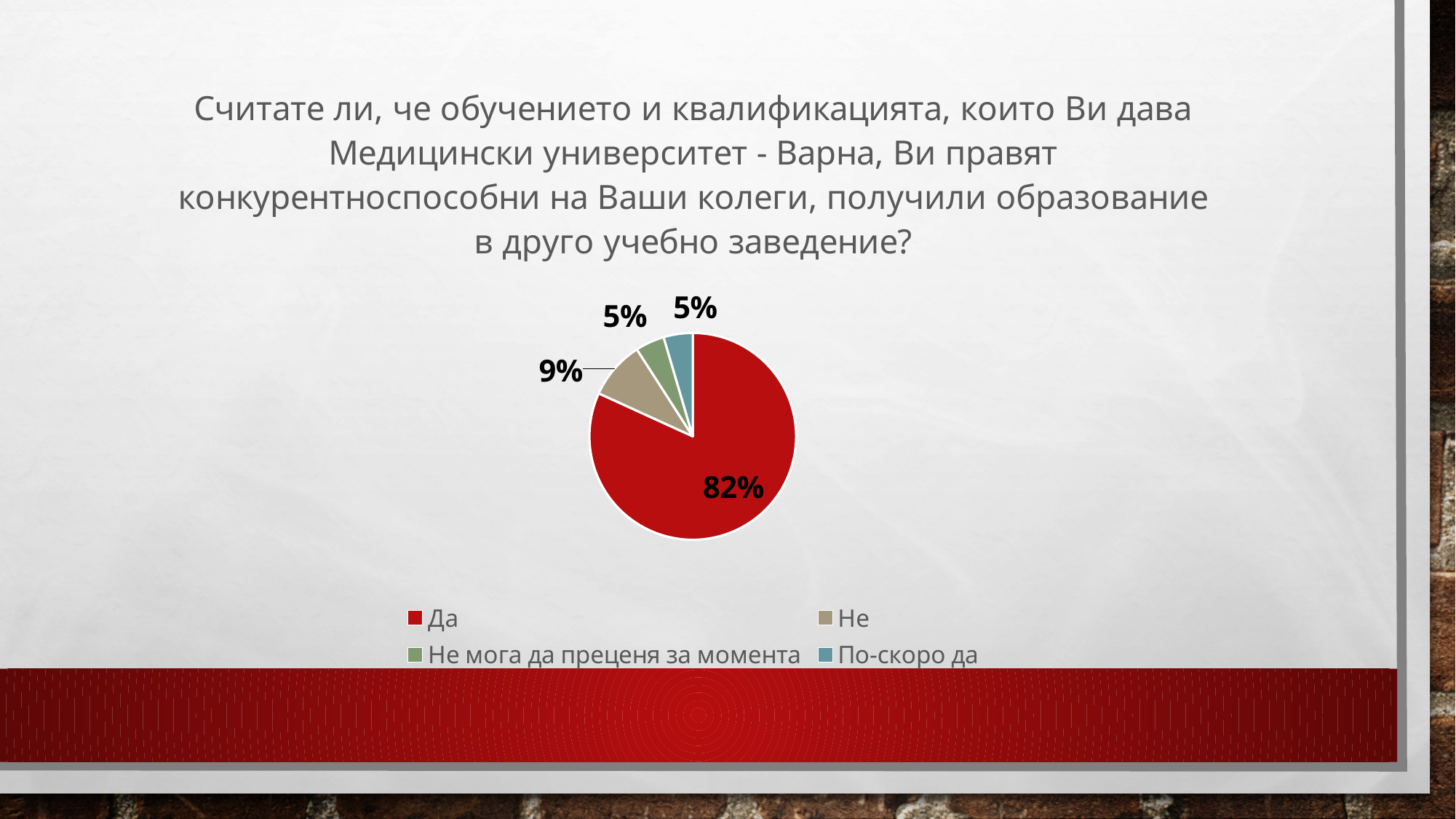
What share of the pie does the "Не мога да преценя за момента" slice represent? 5% What type of chart is shown on the slide? pie chart Which slice is larger, "Не" or "По-скоро да"? Не What share of the pie does the "Да" slice represent? 82% What is the difference in percentage points between the "Не" slice and the "По-скоро да" slice? 4 What is the difference in percentage points between the "Да" slice and the "Не" slice? 73 What colour is the "Да" slice in the pie chart? red What share of the pie does the "По-скоро да" slice represent? 5% How many entries does the legend list? 4 Which category has the largest slice of the pie? Да How many slices does the pie chart have? 4